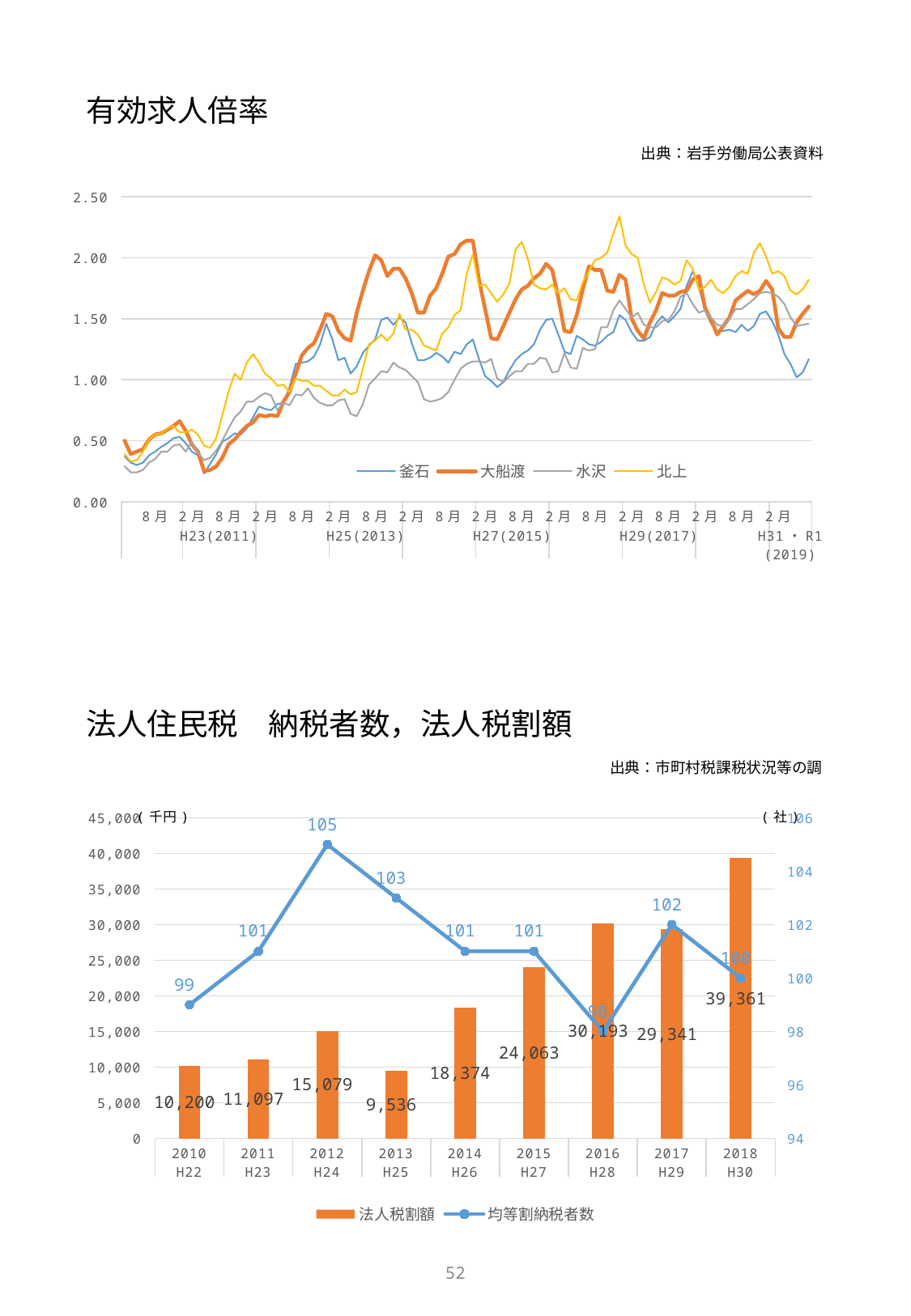
In the 法人住民税 chart, what is the 法人税割額 value for 2018 (H30)? 39,361 In the 法人住民税 chart, what is the 均等割納税者数 value for 2016 (H28)? 98 How many series does the legend of the 有効求人倍率 chart list? 4 In the 法人住民税 chart, what is the 均等割納税者数 value for 2012 (H24)? 105 In the 法人住民税 chart, which year has the highest 均等割納税者数? 2012 (H24) In the 有効求人倍率 chart, is the value for 大船渡 at 8月 H25(2013) greater or less than 1.50? greater In the 法人住民税 chart, which year has the larger 法人税割額, 2016 (H28) or 2017 (H29)? 2016 (H28) What type of chart is the 有効求人倍率 chart? Line chart In the 法人住民税 chart, which year has the lowest 法人税割額? 2013 (H25) In the 有効求人倍率 chart, do the values for 水沢 generally rise or fall from 2011 to 2019? rise In the 法人住民税 chart, how many years are shown on the x axis? 9 In the 法人住民税 chart, what is the difference in 法人税割額 between 2018 (H30) and 2017 (H29)? 10,020